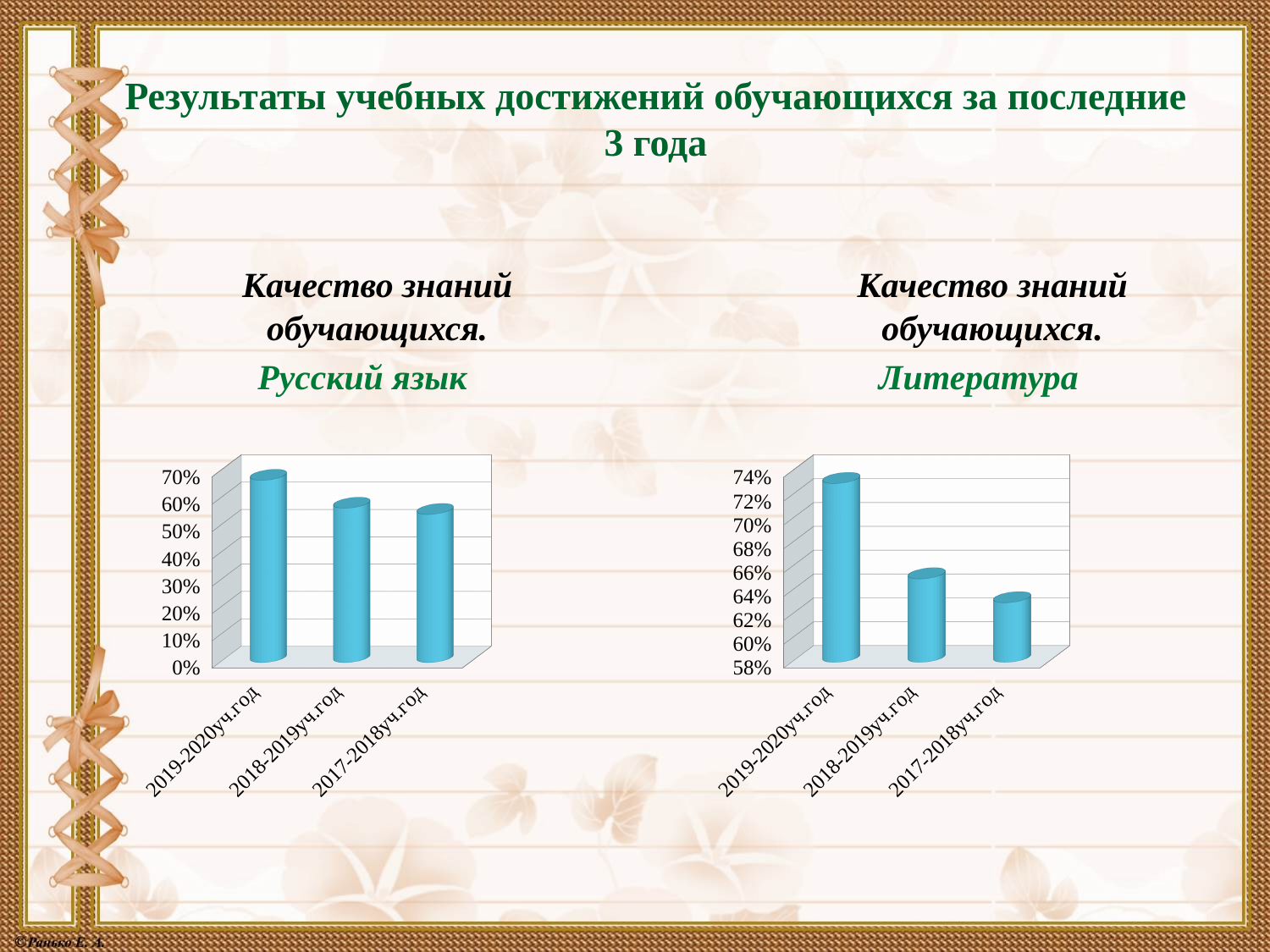
How many categories (school years) are shown on the "Литература" chart on the right? 3 On the "Литература" chart, is the value for 2017-2018уч.год greater or less than 66%? less On the "Русский язык" chart, which school year has the highest value? 2019-2020уч.год On the "Русский язык" chart, is the value for 2019-2020уч.год greater or less than 60%? greater On the "Русский язык" chart, which school year has the lowest value? 2017-2018уч.год On the "Литература" chart, which school year has the lowest value? 2017-2018уч.год On the "Литература" chart, is the value for 2019-2020уч.год greater or less than 70%? greater On the "Литература" chart, which is larger: the value for 2019-2020уч.год or for 2018-2019уч.год? 2019-2020уч.год On the "Русский язык" chart, do the values rise or fall moving from left to right along the x axis? fall On the "Литература" chart, which school year has the highest value? 2019-2020уч.год What kind of chart is the "Русский язык" chart on the left? bar chart